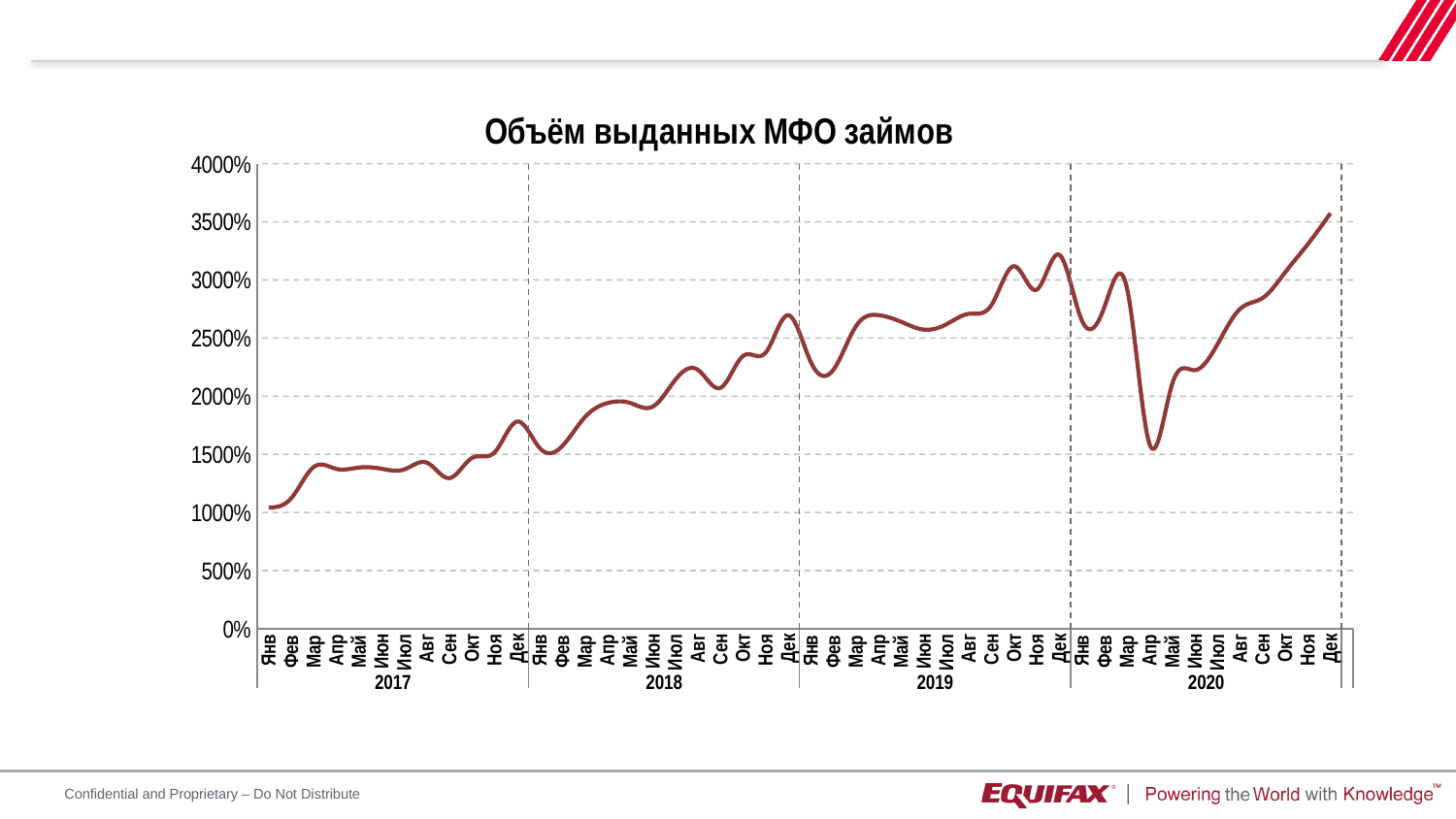
Is the value for Апр 2020 greater or less than 2000%? less Which years does the chart cover? 2017, 2018, 2019, 2020 Is the value for Дек 2020 greater or less than 3000%? greater Which is larger, the value for Янв 2017 or the value for Янв 2018? Янв 2018 What is the title of the chart? Объём выданных МФО займов Which month has the highest value on the chart? Дек 2020 What kind of chart is shown on the slide? line chart Is the value for Янв 2017 greater or less than 1500%? less Which month has the lowest value on the chart? Янв 2017 How many years are labelled along the x axis of the chart? 4 Which is larger, the value for Апр 2019 or the value for Апр 2020? Апр 2019 Overall, do the values rise or fall from January 2017 to December 2020? rise